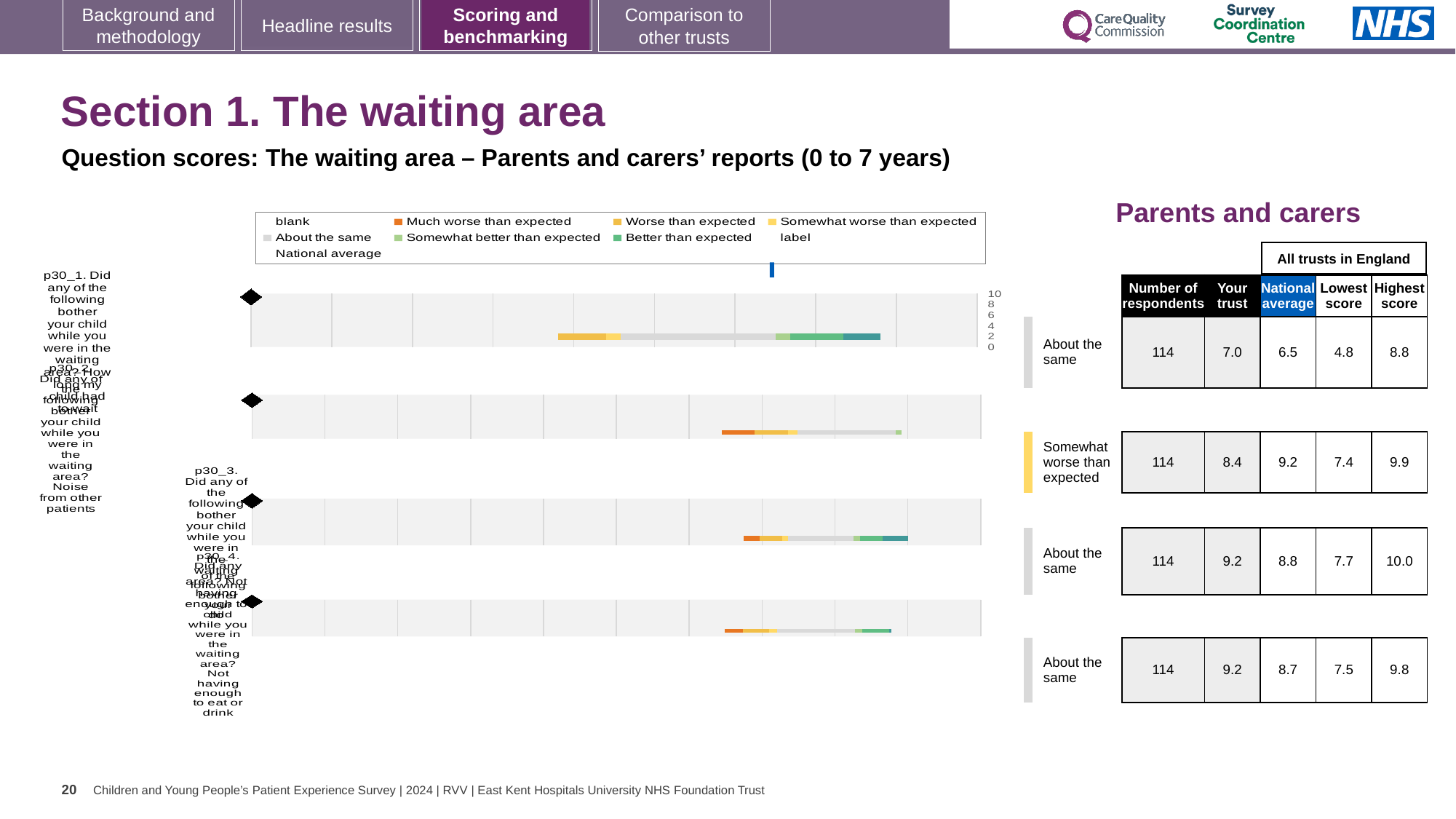
What kind of chart is shown on the slide? bar chart In the table beside the chart, which row has the highest 'Highest score' value? p30_3 (10.0) What heading appears above the table to the right of the chart? Parents and carers In the table beside the chart, which row has the lowest 'Lowest score' value? p30_1 (4.8) In the chart legend, what colour represents 'Much worse than expected'? orange In the table beside the chart, what is the difference between the national average (9.2) and the 'Your trust' score (8.4) for the second row (p30_2)? 0.8 How many survey questions (bars) are plotted in the chart? 4 In the table beside the chart, what is the national average for the second row (p30_2, noise from other patients)? 9.2 In the table beside the chart, what is the 'Your trust' score for the first row (p30_1, waiting area – long wait)? 7.0 How many entries does the chart legend list? 9 In the table beside the chart, what is the number of respondents for each question? 114 In the table beside the chart, for the second row (p30_2), which is larger: the 'Your trust' score or the national average? National average